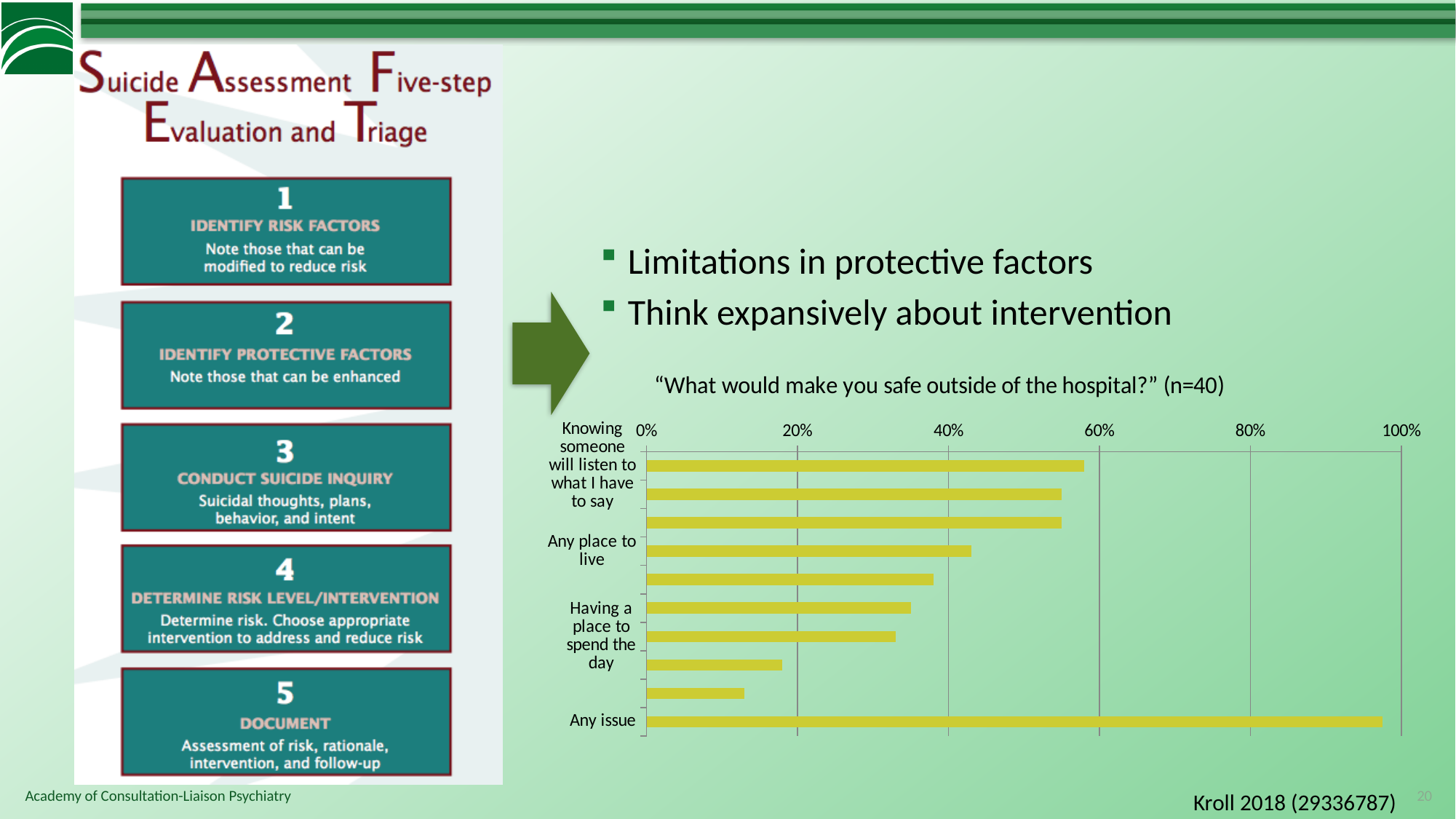
Which is larger, the value for Knowing someone will listen to what I have to say or the value for Having a place to spend the day? Knowing someone will listen to what I have to say Is the value for Having a place to spend the day greater or less than 40%? less What kind of chart is shown on the slide? Bar chart Is the value for Knowing someone will listen to what I have to say greater or less than 40%? greater Is the value for Any issue greater or less than 80%? greater How many bars are plotted in the chart? 10 Which is larger, the value for Any issue or the value for Any place to live? Any issue What is the maximum value shown on the chart's percentage axis? 100% What is the title of the chart? "What would make you safe outside of the hospital?" (n=40) Which category has the highest value in the chart? Any issue